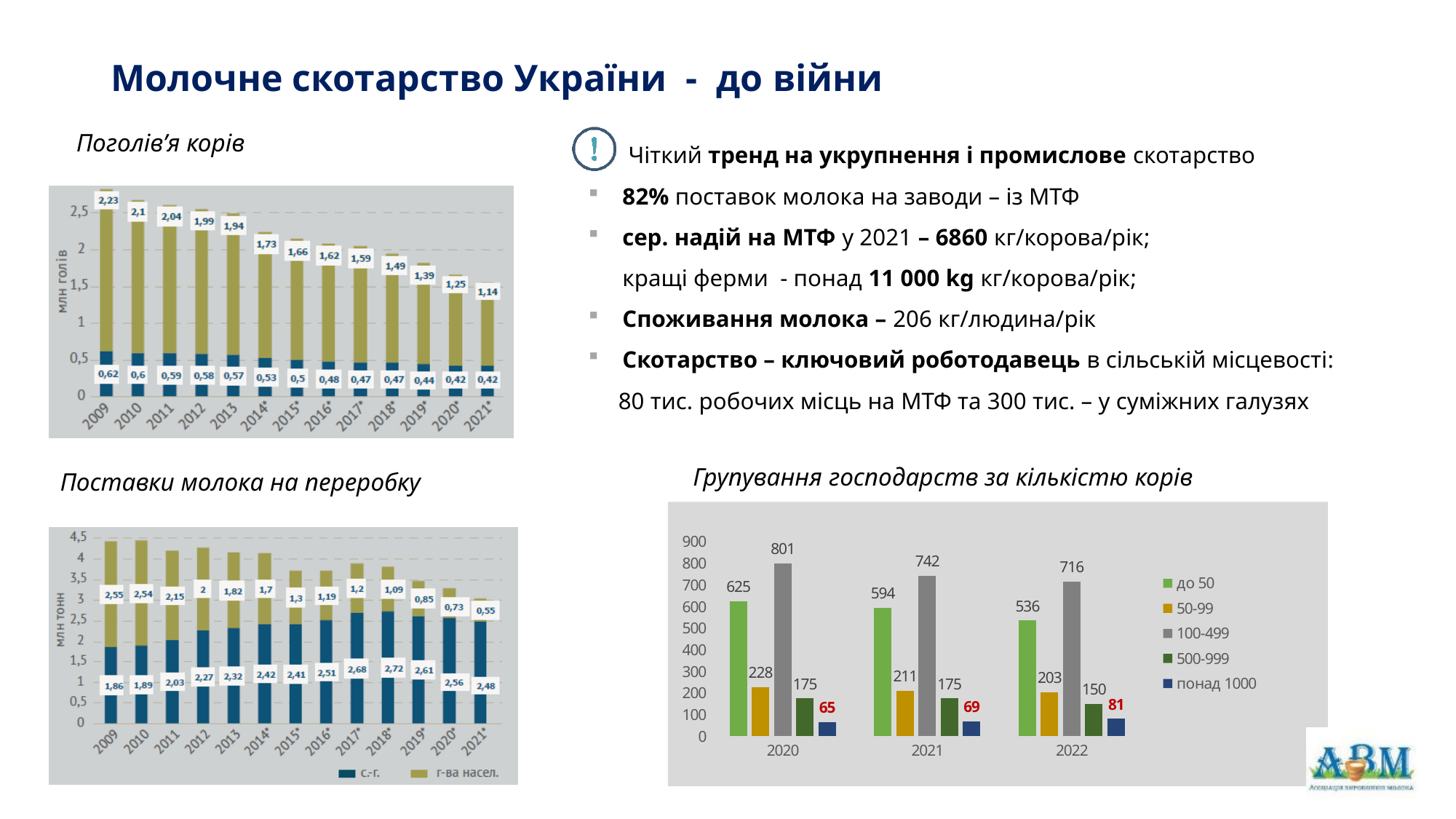
In the chart 'Поголів'я корів', do the values of the upper (olive) segment rise or fall from 2009 to 2021*? fall In the chart 'Групування господарств за кількістю корів', what is the value for the '100-499' group in 2021? 742 How many series does the legend of the chart 'Групування господарств за кількістю корів' list? 5 In the chart 'Поставки молока на переробку', which year has the larger 'г-ва насел.' value, 2009 or 2021*? 2009 In the chart 'Поставки молока на переробку', what is the 'с.-г.' value for 2018*? 2,72 In the chart 'Групування господарств за кількістю корів', which group has the highest value in 2020? 100-499 In the chart 'Поставки молока на переробку', what is the total of the stacked bar for 2021*? 3,03 In the chart 'Поголів'я корів', what is the value of the upper (olive) segment for 2009? 2,23 What kind of chart is 'Поставки молока на переробку'? stacked bar chart How many years are shown on the x axis of the chart 'Поголів'я корів'? 13 In the chart 'Групування господарств за кількістю корів', does the 'понад 1000' series rise or fall from 2020 to 2022? rises In the chart 'Групування господарств за кількістю корів', what is the difference between the 'до 50' value in 2020 and in 2022? 89